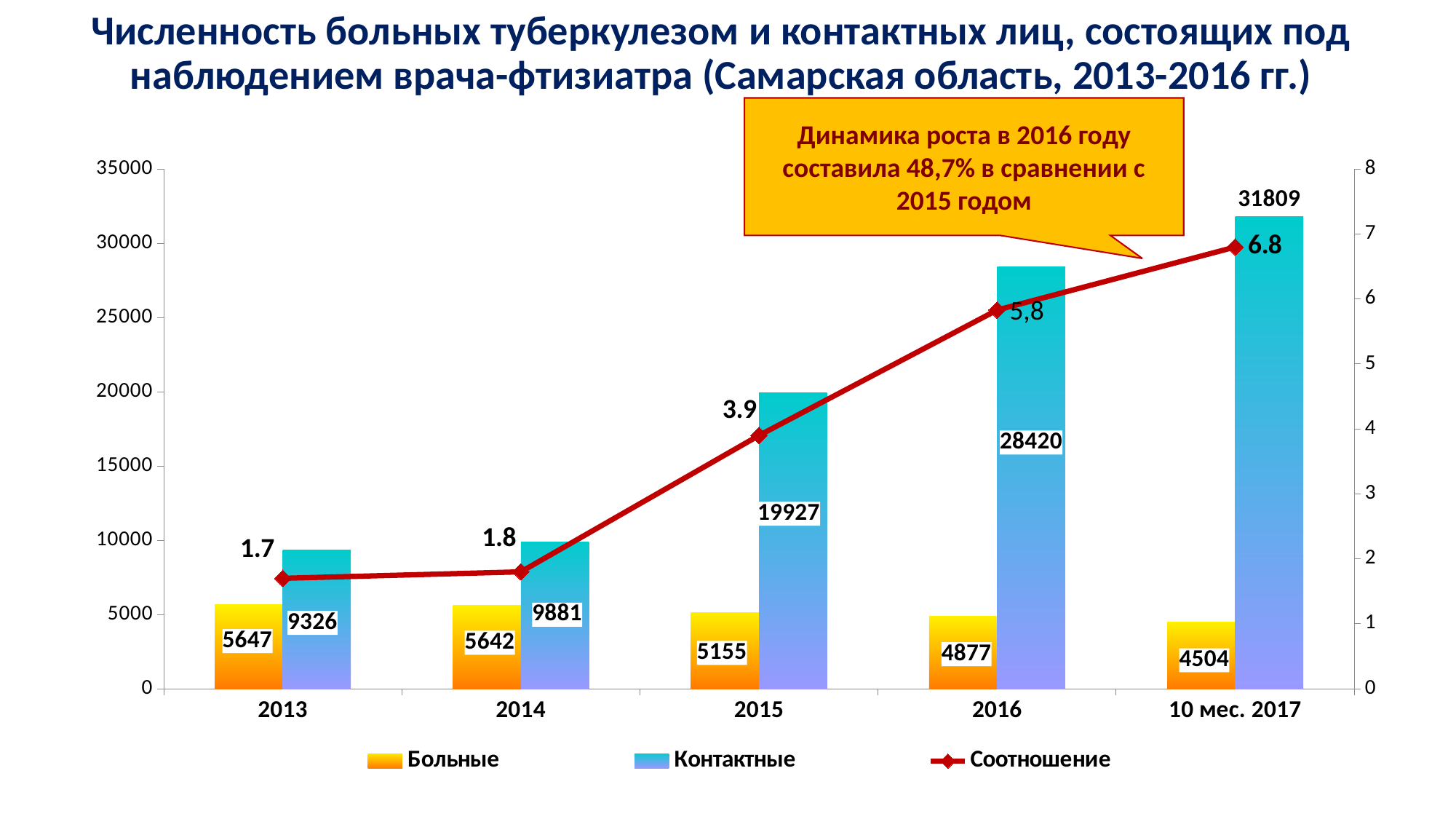
Which category has the highest value for Контактные? 10 мес. 2017 What is the Соотношение value for 2015? 3.9 What is the value of Контактные for 10 мес. 2017? 31809 What is the difference between the Контактные values for 2016 and 2015? 8493 Which category has the lowest value for Больные? 10 мес. 2017 How many categories are shown on the x axis? 5 What is the value of Больные for 2013? 5647 What is the value of Контактные for 2016? 28420 Which is larger: Больные in 2015 or Больные in 2016? Больные in 2015 How many series does the legend list? 3 Which series is drawn as a line with markers? Соотношение Does the Больные series rise or fall from 2013 to 10 мес. 2017? fall